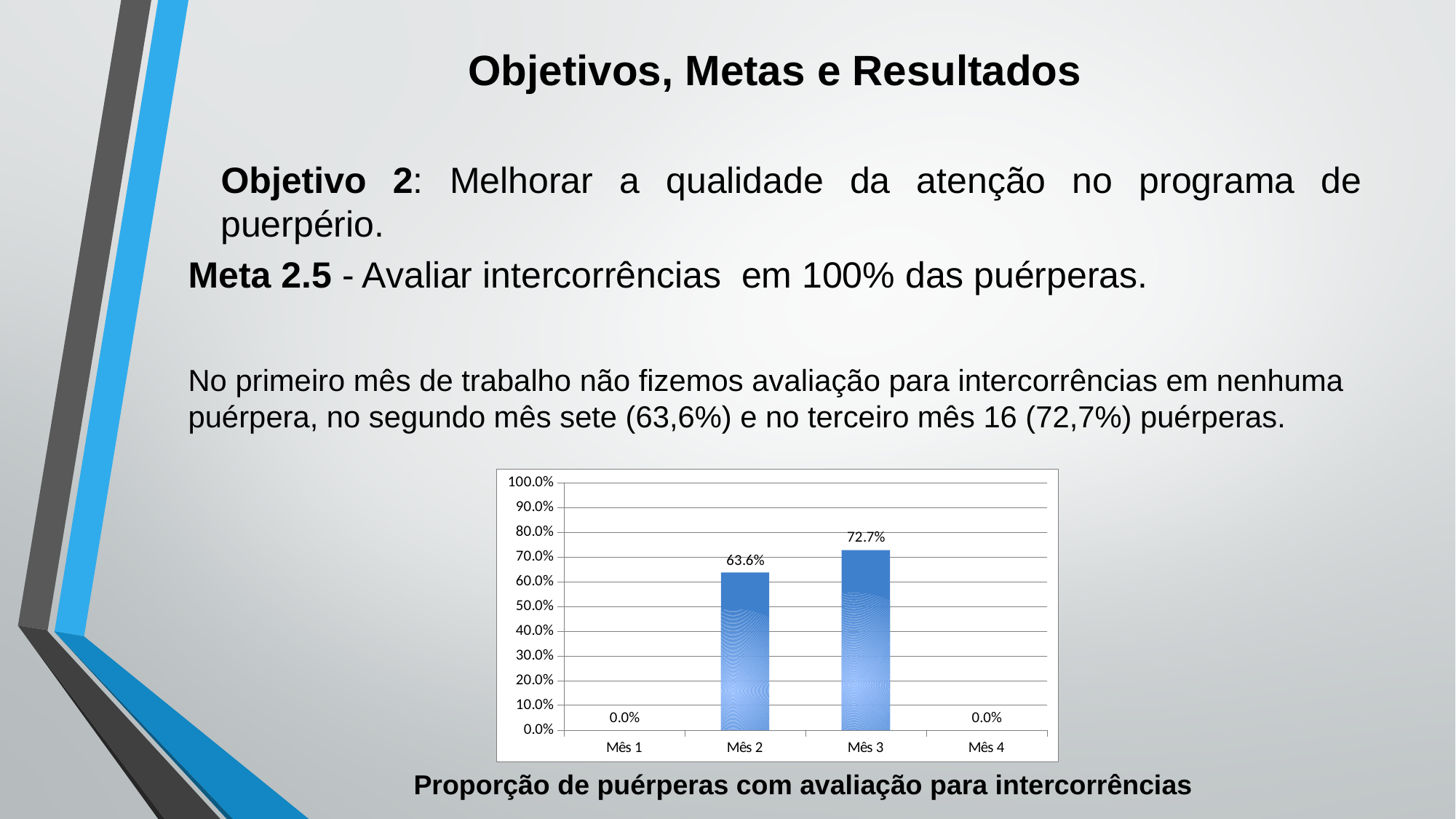
What is the difference between the values for Mês 3 and Mês 2? 9.1% What is the value for Mês 1? 0.0% How many categories are shown on the x axis? 4 Which is larger, the value for Mês 2 or the value for Mês 3? Mês 3 Is the value for Mês 3 greater or less than 70.0%? greater Is the value for Mês 2 greater or less than 70.0%? less Which month has the highest value? Mês 3 What is the value for Mês 2? 63.6% What is the title printed below the chart? Proporção de puérperas com avaliação para intercorrências What is the value for Mês 3? 72.7% What is the value for Mês 4? 0.0% What kind of chart is shown on the slide? bar chart